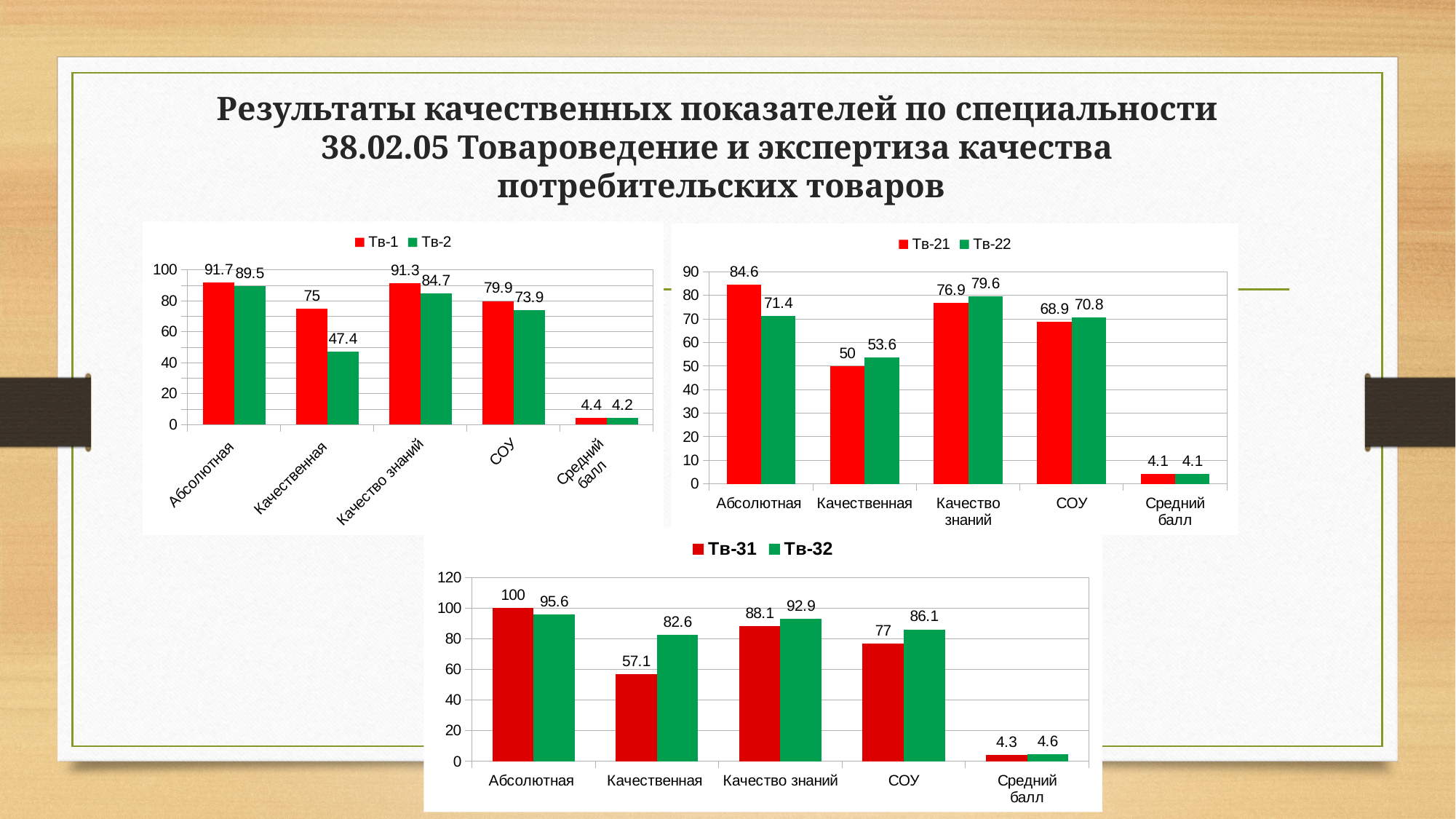
In the bottom chart (Тв-31 and Тв-32), what is the difference between Тв-32 and Тв-31 in the Качественная category? 25.5 In the top-left chart (Тв-1 and Тв-2), what is the value for Тв-2 in the СОУ category? 73.9 In the bottom chart (Тв-31 and Тв-32), what is the value for Тв-31 in the Абсолютная category? 100 In the top-left chart (Тв-1 and Тв-2), what is the difference between Тв-1 and Тв-2 in the Качественная category? 27.6 In the top-right chart (Тв-21 and Тв-22), which is larger in the Качество знаний category, Тв-21 or Тв-22? Тв-22 In the bottom chart (Тв-31 and Тв-32), what colour represents the Тв-32 series? Green In the top-right chart (Тв-21 and Тв-22), which category has the lowest value for Тв-21? Средний балл In the bottom chart (Тв-31 and Тв-32), how many categories are shown on the x axis? 5 In the top-right chart (Тв-21 and Тв-22), how many series does the legend list? 2 In the top-right chart (Тв-21 and Тв-22), what is the value for Тв-22 in the Абсолютная category? 71.4 In the top-left chart (Тв-1 and Тв-2), what is the value for Тв-1 in the Качественная category? 75 What kind of chart is the bottom chart (Тв-31 and Тв-32)? Bar chart